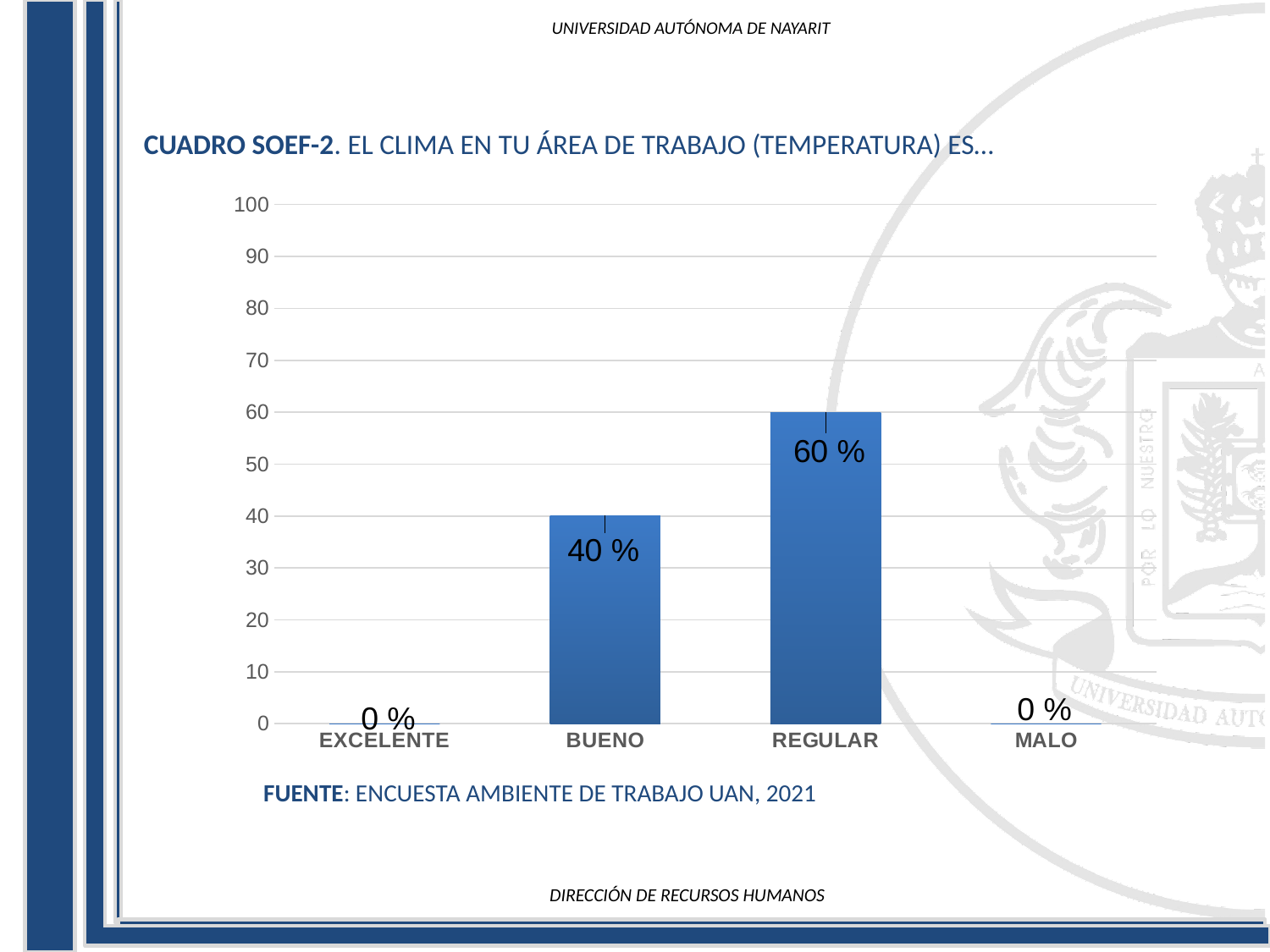
What is the value for BUENO? 40 % What is the source cited below the chart? ENCUESTA AMBIENTE DE TRABAJO UAN, 2021 Which is larger, the value for BUENO or the value for REGULAR? REGULAR What is the highest value shown on the vertical axis? 100 What is the difference between the values for REGULAR and BUENO? 20 % What is the value for MALO? 0 % Is the value for REGULAR greater or less than 50? greater What is the value for REGULAR? 60 % Which category has the highest value? REGULAR How many categories are shown on the x axis? 4 What is the value for EXCELENTE? 0 % What kind of chart is shown on the slide? bar chart